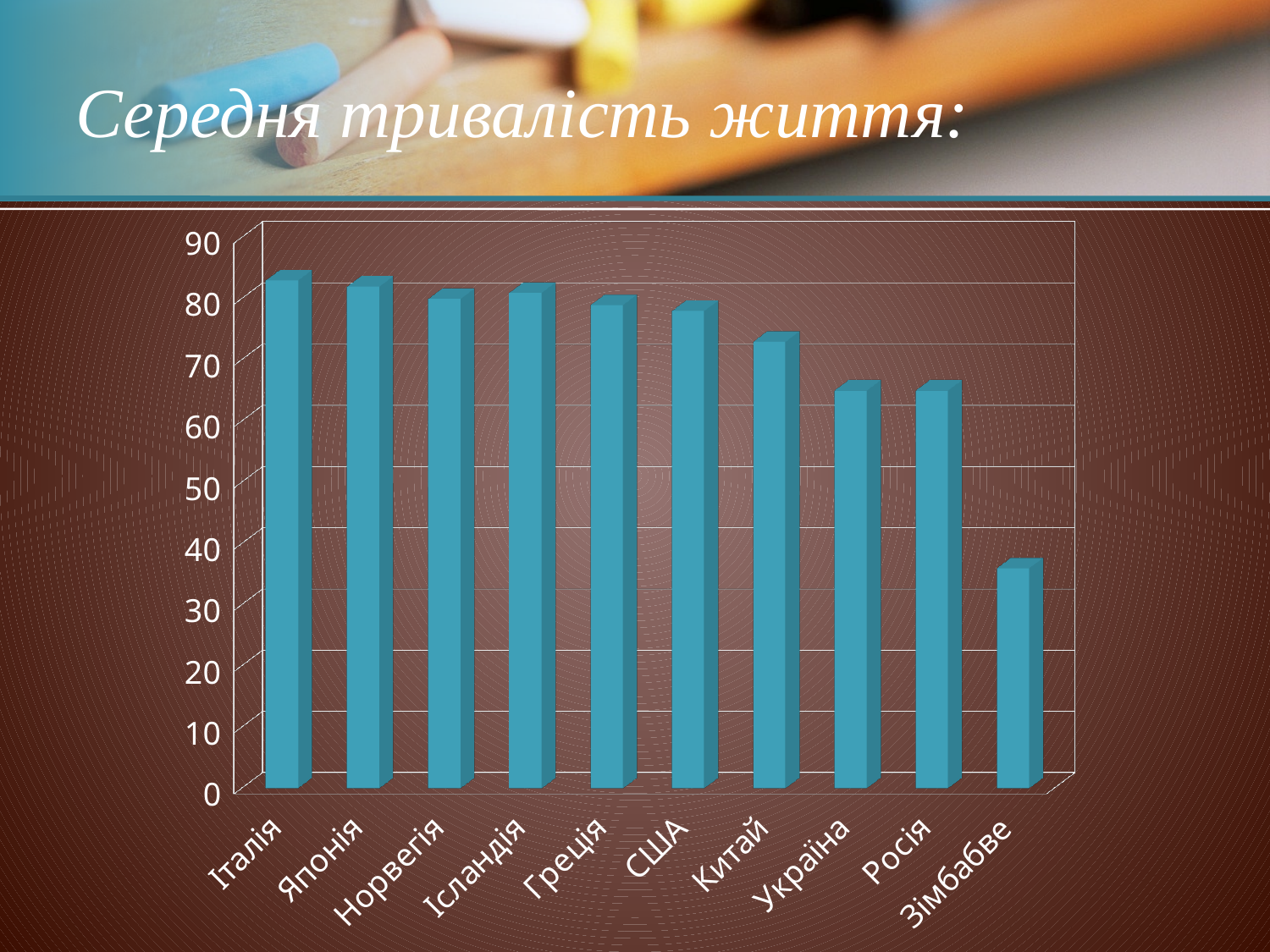
Do the values generally rise or fall from left to right along the x axis? fall How many countries are shown on the chart? 10 What kind of chart is shown on the slide? bar chart Is the value for Україна greater or less than 70? less Is the value for Італія greater or less than 80? greater Is the value for Китай greater or less than 70? greater What is the title of the slide containing the chart? Середня тривалість життя: Which is larger, the value for Китай or the value for Україна? Китай Which is larger, the value for Зімбабве or the value for США? США Which country has the lowest value on the chart? Зімбабве